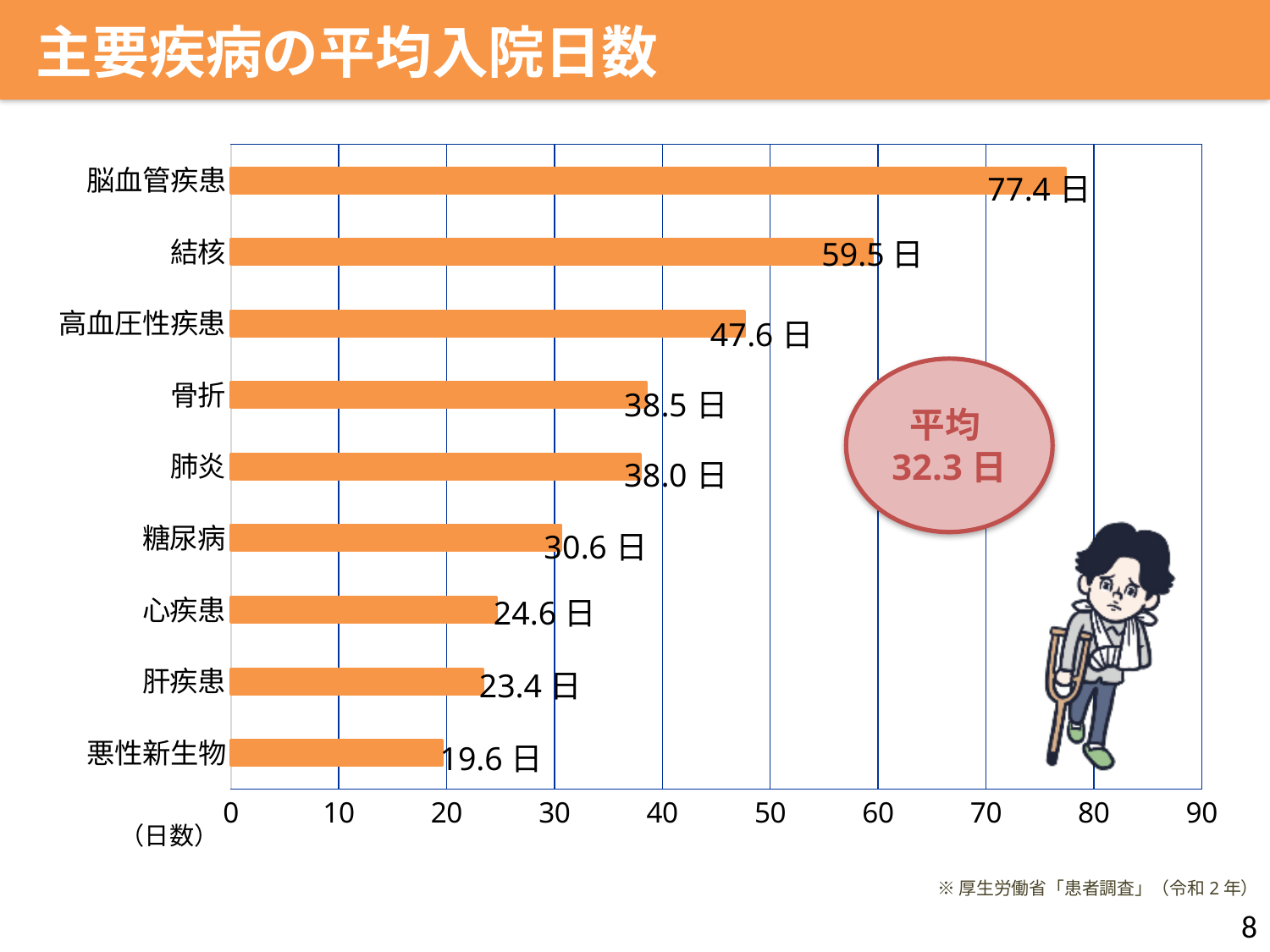
Is the value for 結核 greater or less than 50? greater What is the average hospital stay for 脳血管疾患? 77.4 日 How many diseases are shown in the chart? 9 What is the average hospital stay for 悪性新生物? 19.6 日 What is the overall average hospital stay shown in the circle on the slide? 32.3 日 What is the difference in average hospital stay between 脳血管疾患 and 結核? 17.9 日 What is the average hospital stay for 糖尿病? 30.6 日 Which has a longer average hospital stay, 高血圧性疾患 or 骨折? 高血圧性疾患 Which disease has the longest average hospital stay? 脳血管疾患 What is the title of the chart? 主要疾病の平均入院日数 Which disease has the shortest average hospital stay? 悪性新生物 What kind of chart is shown on the slide? bar chart